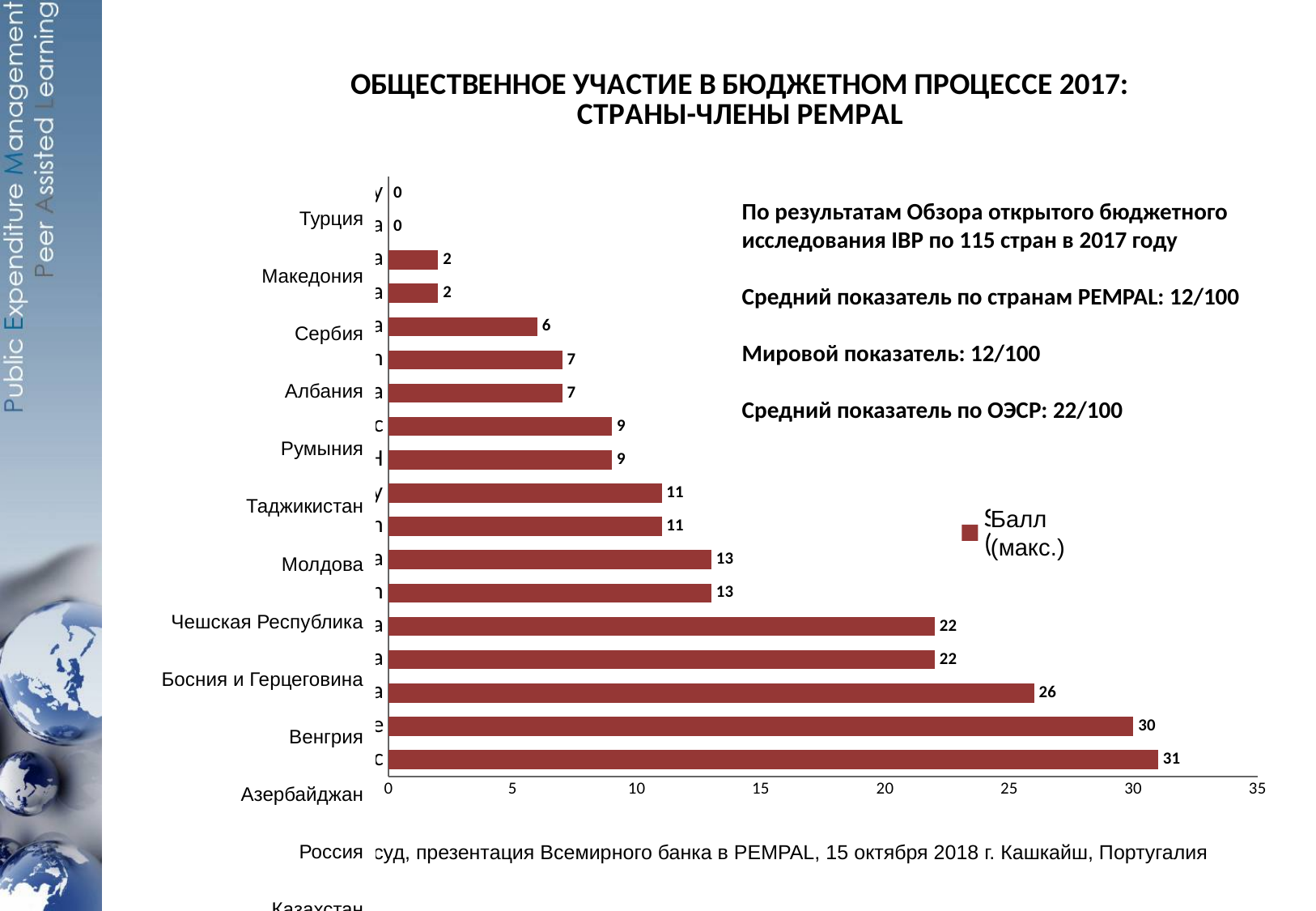
What is the second-highest value shown by a bar in the chart? 30 How many bars are plotted in the chart? 18 What is the lowest value shown by any bar in the chart? 0 What kind of chart is shown on the slide? bar chart What is the highest value shown by any bar in the chart? 31 How many bars in the chart have a value greater than 20? 5 What is the difference between the bar labelled 26 and the bar labelled 22? 4 What is the difference between the longest bar (31) and the second-longest bar (30)? 1 Is the longest bar in the chart greater or less than 30? greater How many series does the legend list? 1 What is the maximum value shown on the horizontal axis? 35 How many bars in the chart have a value of 0? 2